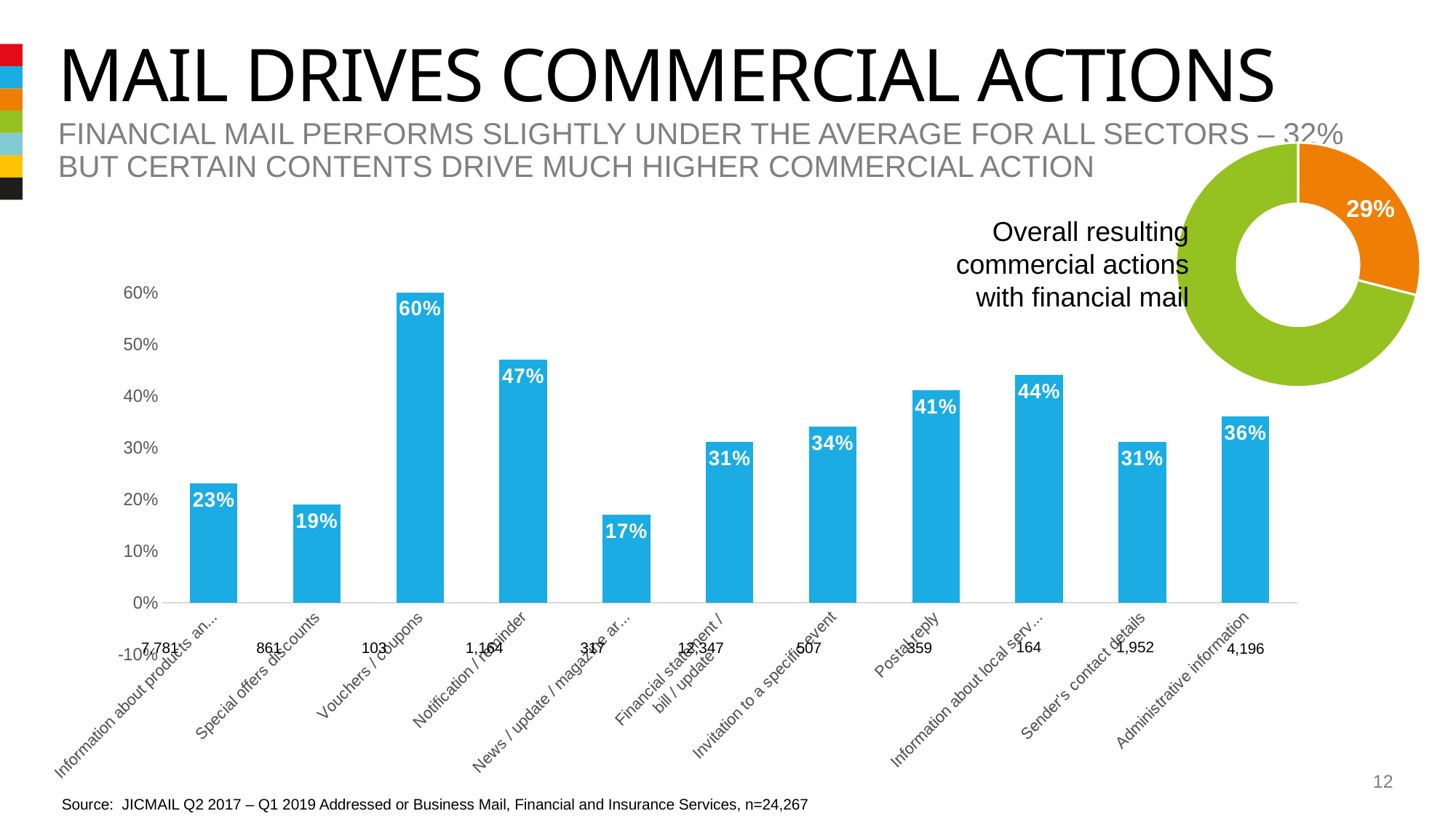
In the bar chart, which is larger: the value for Postal reply or the value for Information about local serv...? Information about local serv... In the bar chart, which category has the highest value? Vouchers / coupons In the bar chart, which category has the lowest value? News / update / magazine ar... What kind of chart is the large chart on the left of the slide? Bar chart In the bar chart, what is the value for Notification / reminder? 47% In the donut chart on the right, what percentage is shown on the orange slice? 29% What is the title text next to the donut chart on the right? Overall resulting commercial actions with financial mail In the bar chart, what is the value for Administrative information? 36% How many categories are shown in the bar chart? 11 In the bar chart, what is the difference between the values for Vouchers / coupons and Special offers discounts? 41 percentage points In the bar chart, is the value for Invitation to a specific event greater or less than 30%? greater In the bar chart, what is the value for Vouchers / coupons? 60%